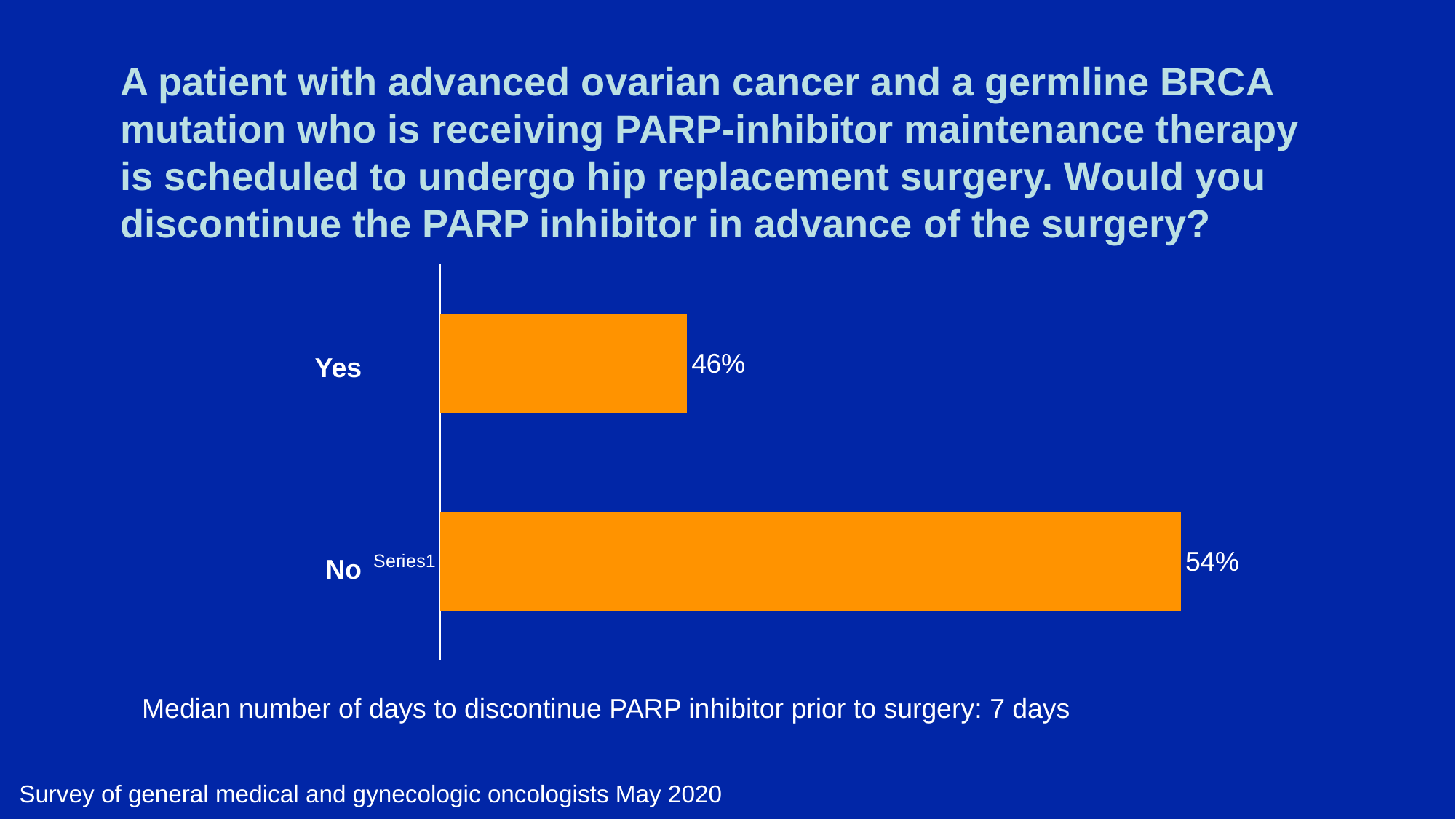
How many response categories are shown in the chart? 2 What percentage of respondents answered Yes? 46% Is the value for Yes larger or smaller than the value for No? smaller Which response received the larger share of respondents? No What percentage of respondents answered No? 54% What is the difference in percentage points between the No and Yes responses? 8 Which response received the smaller share of respondents? Yes What is the total of the Yes and No percentages? 100% What colour are the bars in the chart? orange What type of chart is shown on the slide? bar chart According to the text below the chart, what is the median number of days to discontinue the PARP inhibitor prior to surgery? 7 days